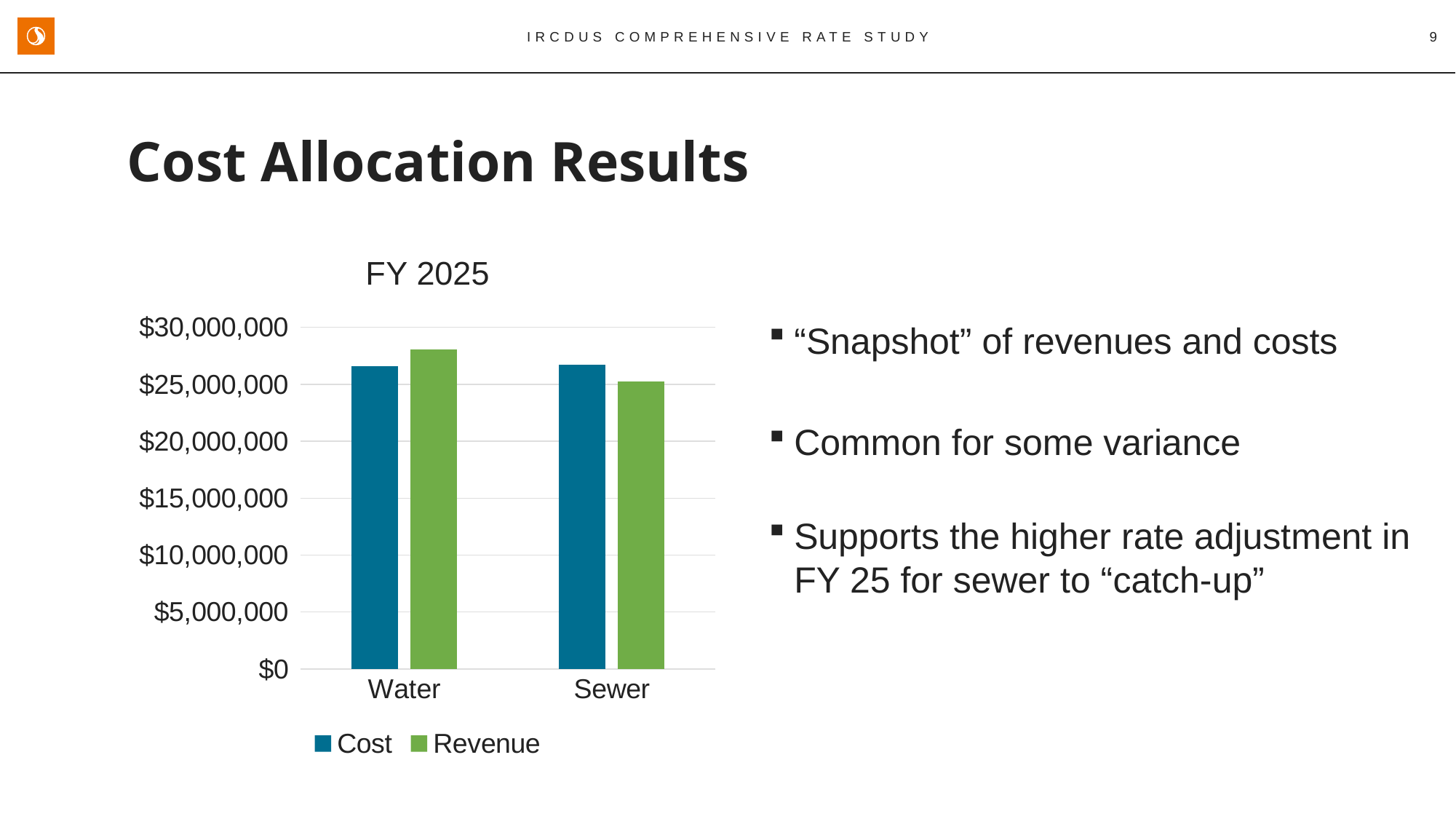
Which bar is the shortest in the chart? Sewer Revenue How many series does the chart legend list? 2 How many categories are shown on the x axis of the chart? 2 What type of chart is shown on the slide? Bar chart Is the Cost value for Sewer greater or less than $25,000,000? greater Is the Revenue value for Sewer greater or less than $30,000,000? less Is the Revenue value for Water greater or less than $25,000,000? greater For Sewer, which is larger, Cost or Revenue? Cost Which bar is the tallest in the chart? Water Revenue What is the title of the chart? FY 2025 Which series are listed in the chart legend? Cost and Revenue For Water, which is larger, Cost or Revenue? Revenue